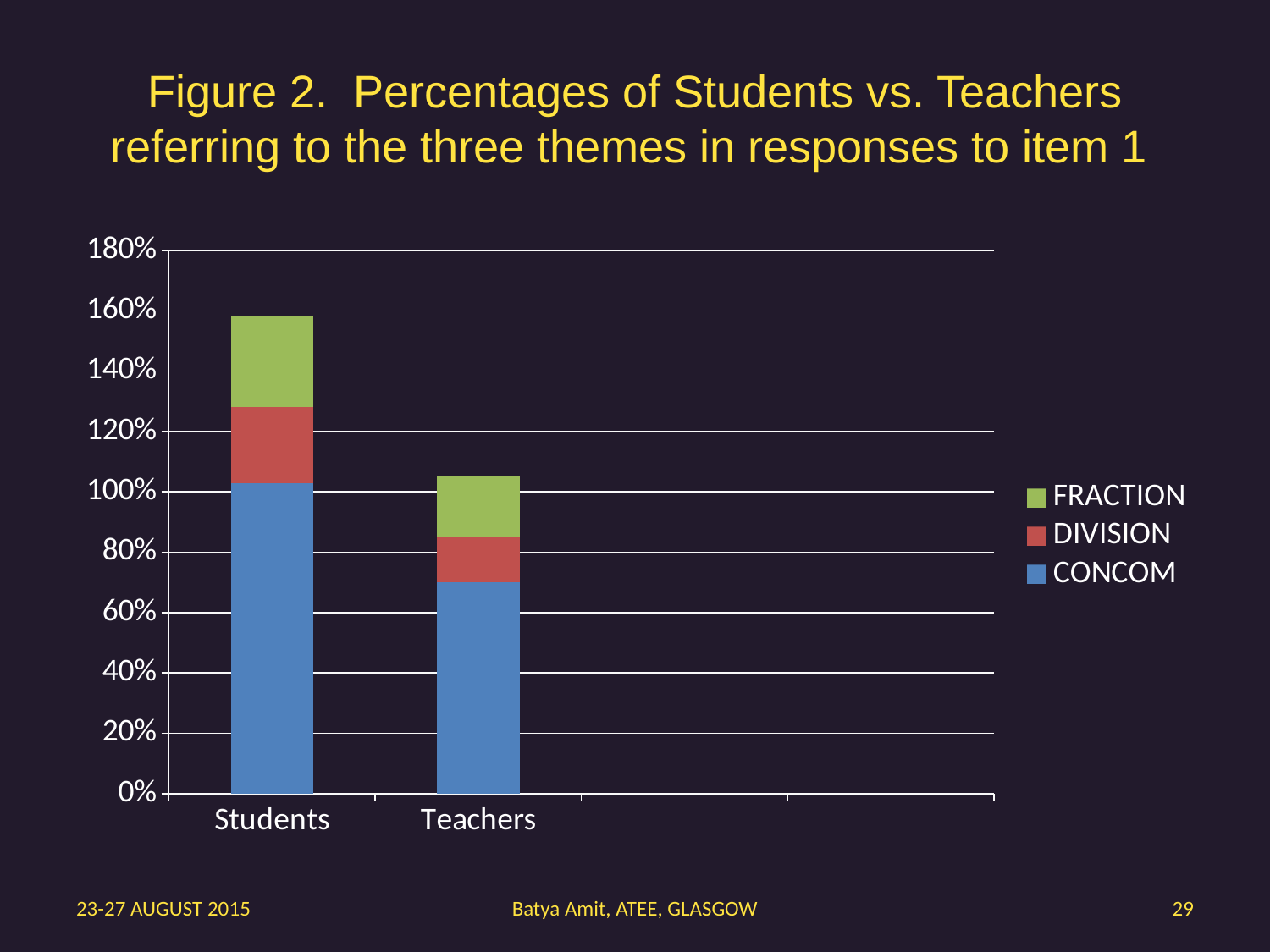
Is the CONCOM value for Students greater or less than 80%? greater Is the total stacked value for Students greater or less than 140%? greater What kind of chart is shown on the slide? stacked bar chart What is the figure number given in the slide title? Figure 2 How many series does the legend list? 3 Is the total stacked value for Teachers greater or less than 120%? less Which series is shown in green in the legend? FRACTION Which category has the lowest total stacked bar? Teachers How many categories are shown on the x axis? 2 Which category has the taller stacked bar, Students or Teachers? Students Which series is the largest segment in the Students bar? CONCOM